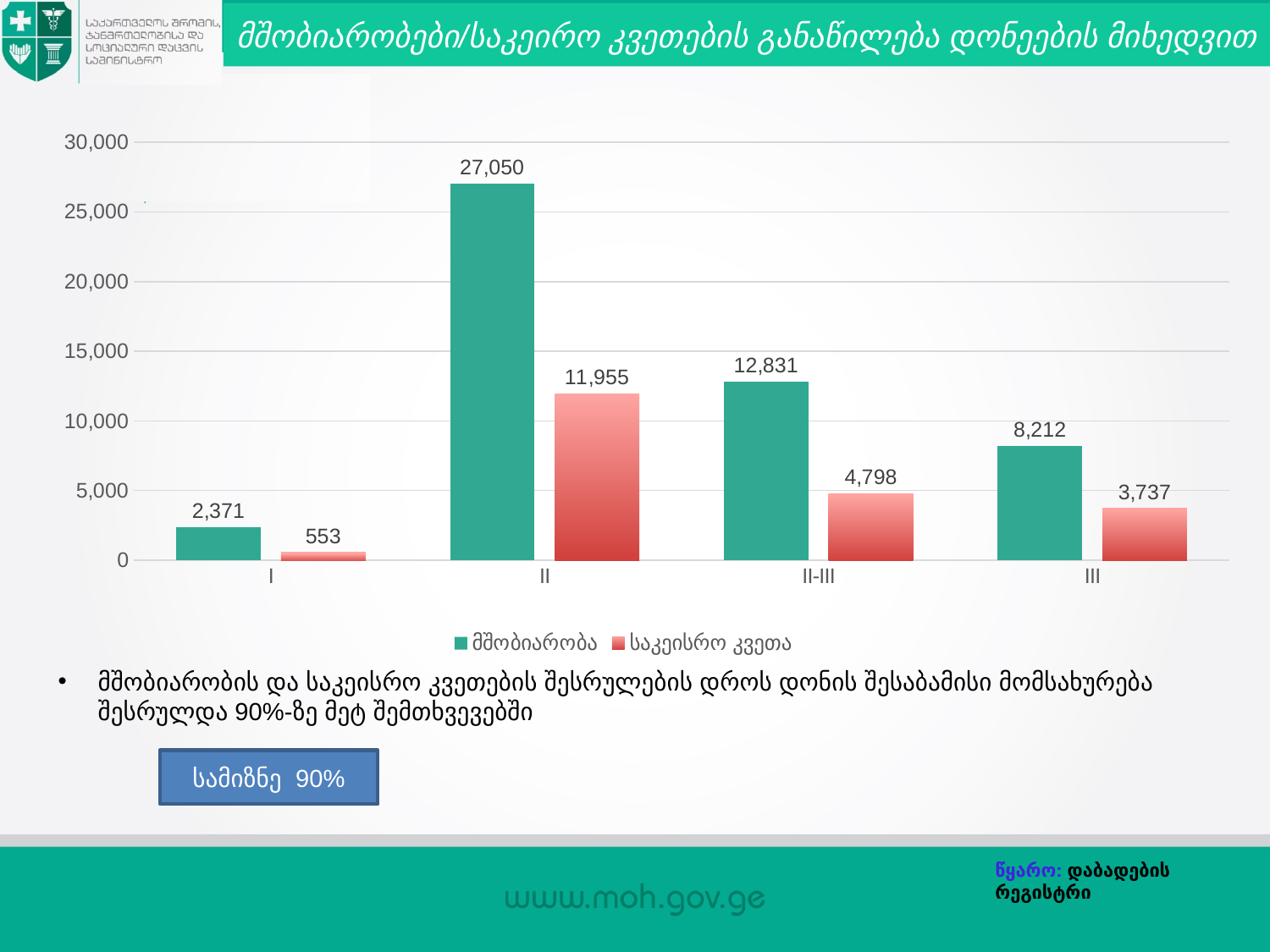
What is the value of the საკეისრო კვეთა series for level I? 553 What is the value of the საკეისრო კვეთა series for level II-III? 4,798 How many series does the legend list? 2 Which is larger: the საკეისრო კვეთა value for level II-III or for level III? II-III What is the difference between the მშობიარობა and საკეისრო კვეთა values for level II? 15,095 Which level has the lowest value for the საკეისრო კვეთა series? I Is the მშობიარობა value for level II-III greater or less than 10,000? greater What is the value of the მშობიარობა series for level II? 27,050 How many levels (categories) are shown on the x axis? 4 What kind of chart is shown on the slide? bar chart What is the value of the მშობიარობა series for level III? 8,212 Which level has the highest value for the მშობიარობა series? II